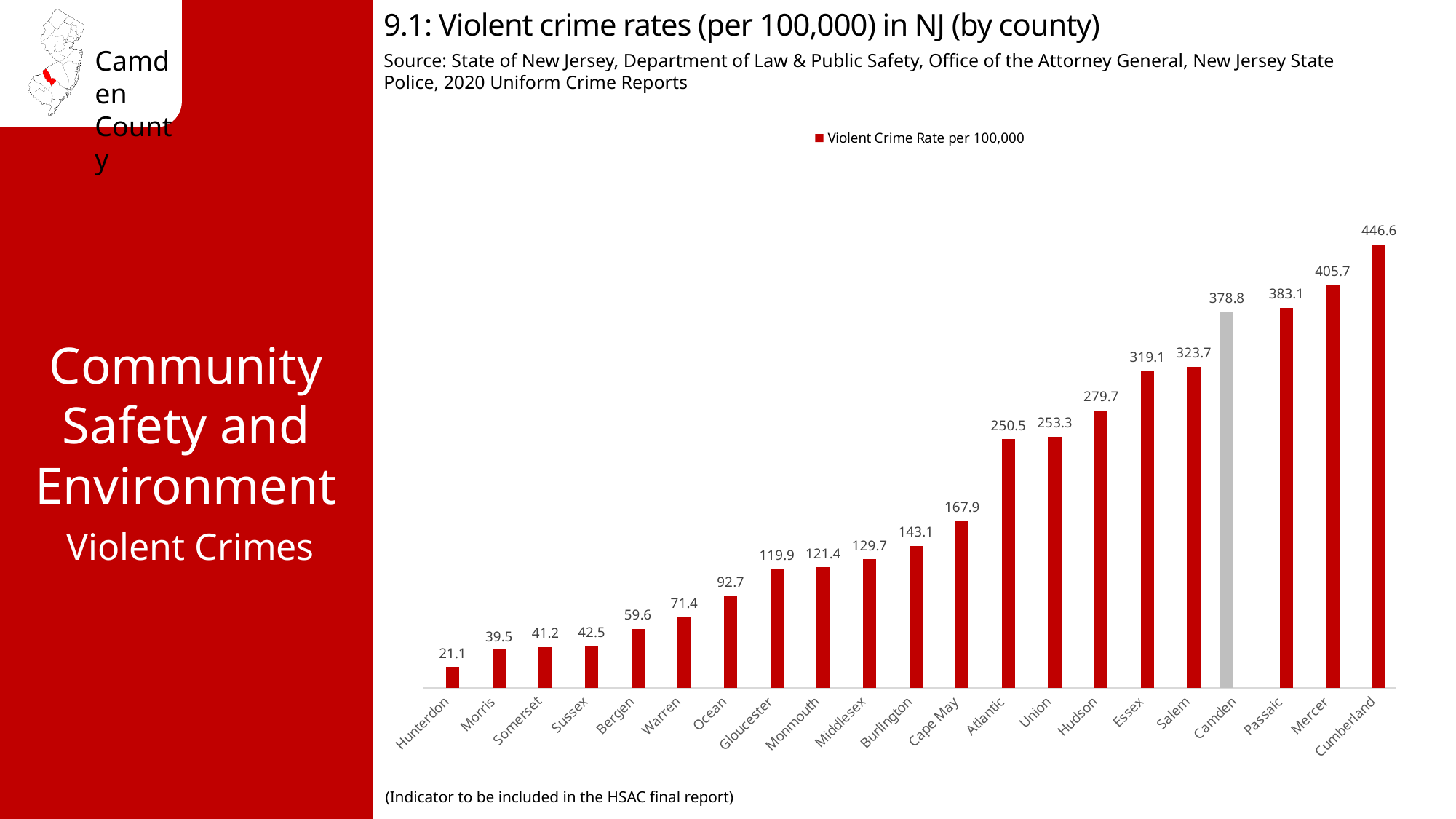
What is the violent crime rate per 100,000 for Hunterdon County? 21.1 What is the difference between the violent crime rates of Cumberland and Camden? 67.8 Do the values rise or fall from left to right along the x axis? Rise What is the violent crime rate per 100,000 for Cape May County? 167.9 Which county has a higher violent crime rate, Hudson or Essex? Essex Which county has the lowest violent crime rate? Hunterdon How many series does the legend list? 1 What is the violent crime rate per 100,000 for Camden County? 378.8 How many counties are shown on the chart? 21 Which county has the highest violent crime rate? Cumberland What is the difference between the violent crime rates of Camden and Hunterdon? 357.7 What kind of chart is shown on the slide? Bar chart